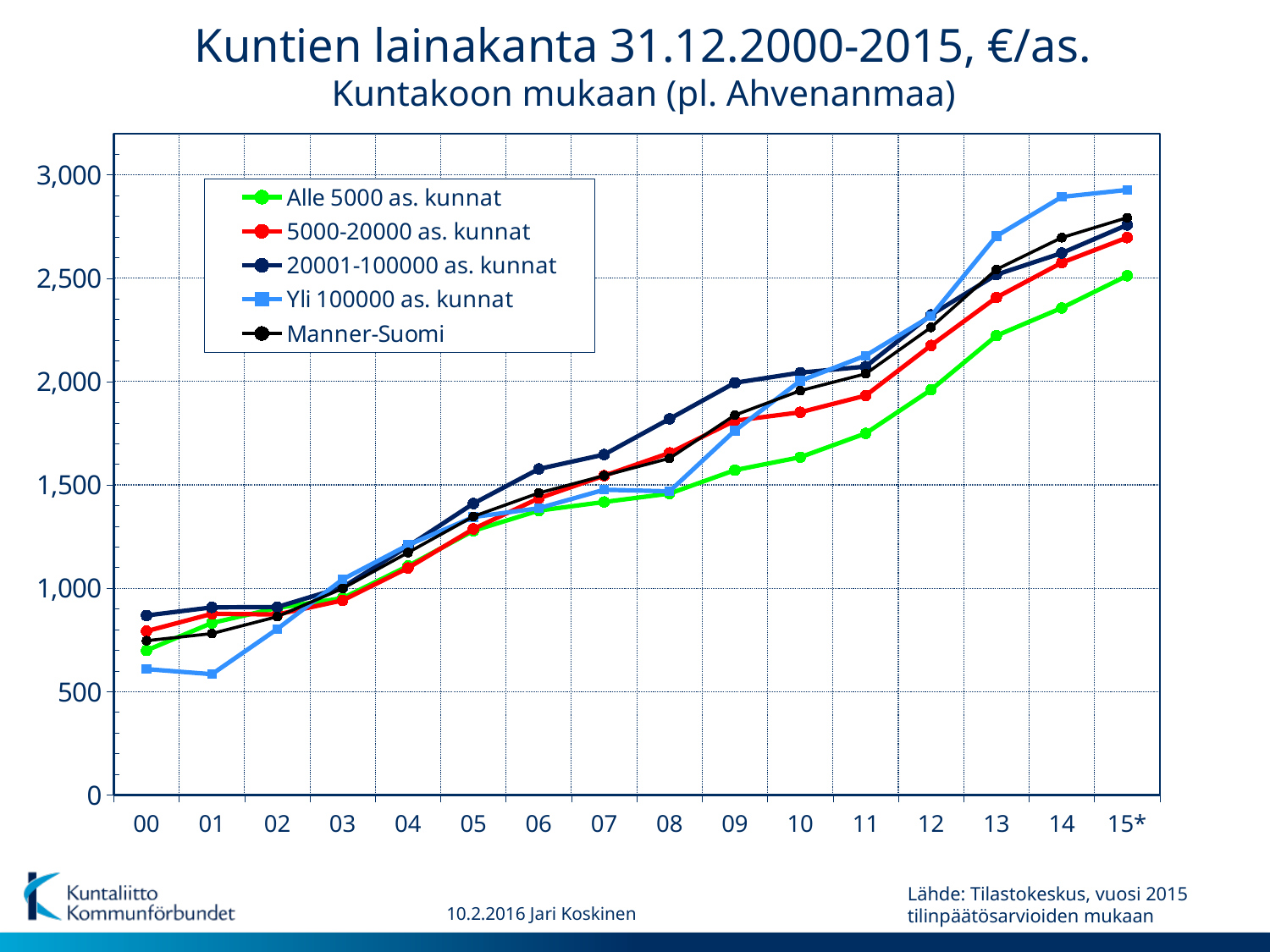
Is the value for Yli 100000 as. kunnat in 15* greater or less than 2,500? greater In 08, which is higher: Yli 100000 as. kunnat or 20001-100000 as. kunnat? 20001-100000 as. kunnat Is the value for Yli 100000 as. kunnat in 01 greater or less than 1,000? less Which series has the lowest value in 00? Yli 100000 as. kunnat How many years are plotted along the x axis? 16 How many series does the legend list? 5 Is the value for Alle 5000 as. kunnat in 14 greater or less than 2,500? less Do the values for Manner-Suomi generally rise or fall from 00 to 15*? rise Which series has the highest value in 15*? Yli 100000 as. kunnat What is the title of the chart? Kuntien lainakanta 31.12.2000-2015, €/as. Which series has the lowest value in 15*? Alle 5000 as. kunnat What kind of chart is shown on the slide? line chart